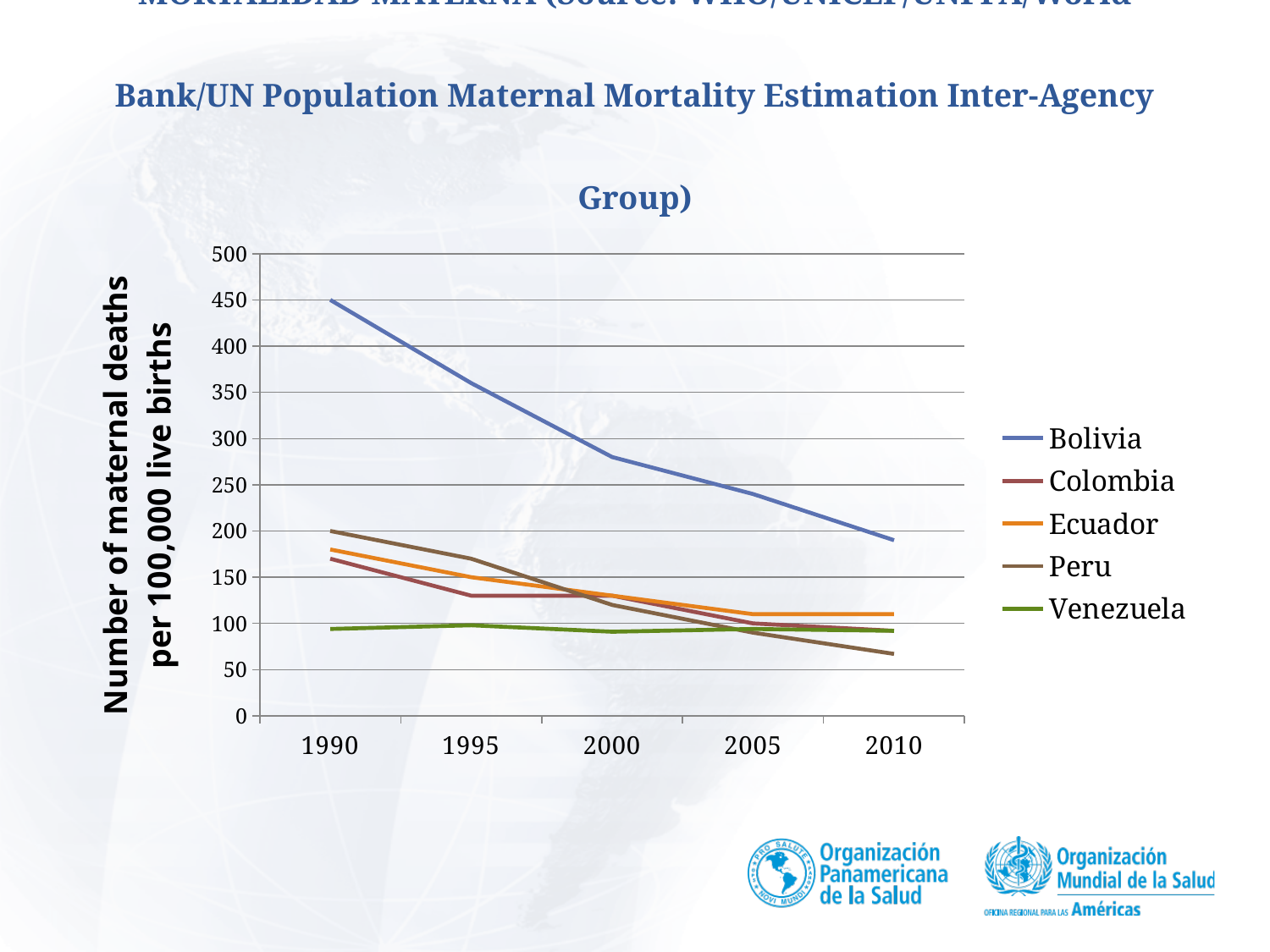
Is the value for Bolivia in 2000 greater or less than 250? greater Is the value for Bolivia in 2005 greater or less than 300? less Which country has the lowest maternal mortality value in 2010? Peru How many series does the legend list? 5 What is the label of the y axis? Number of maternal deaths per 100,000 live births Which is larger in 2000, the value for Bolivia or the value for Venezuela? Bolivia Is the value for Peru in 2010 greater or less than 100? less How many years are shown on the x axis? 5 What kind of chart is shown on the slide? line chart Does the value for Bolivia rise or fall from 1990 to 2010? fall Which country has the highest maternal mortality value in 1990? Bolivia